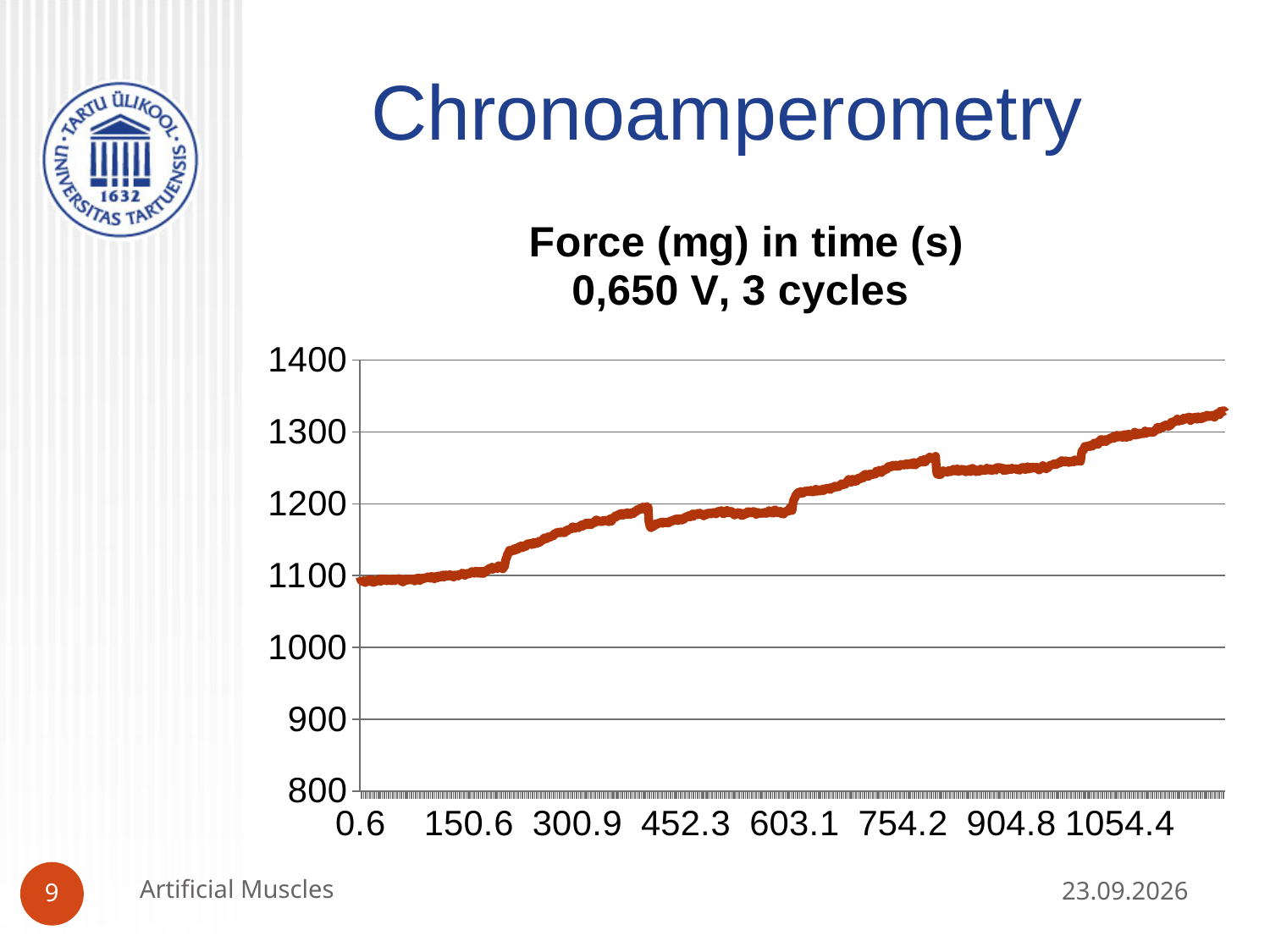
Which is larger, the force value at time 904.8 or at time 150.6? 904.8 Do the force values generally rise or fall as time increases along the x axis? rise Is the force value at time 904.8 greater or less than 1300? less How many labeled tick marks are shown on the x axis? 8 Is the force value at time 0.6 greater or less than 1200? less Is the force value at time 754.2 greater or less than 1200? greater What kind of chart is shown on the slide? line chart What is the lowest value labeled on the y axis? 800 What is the title of the chart? Force (mg) in time (s) 0,650 V, 3 cycles At which end of the time axis does the force reach its highest value, the start (0.6) or the end (after 1054.4)? the end